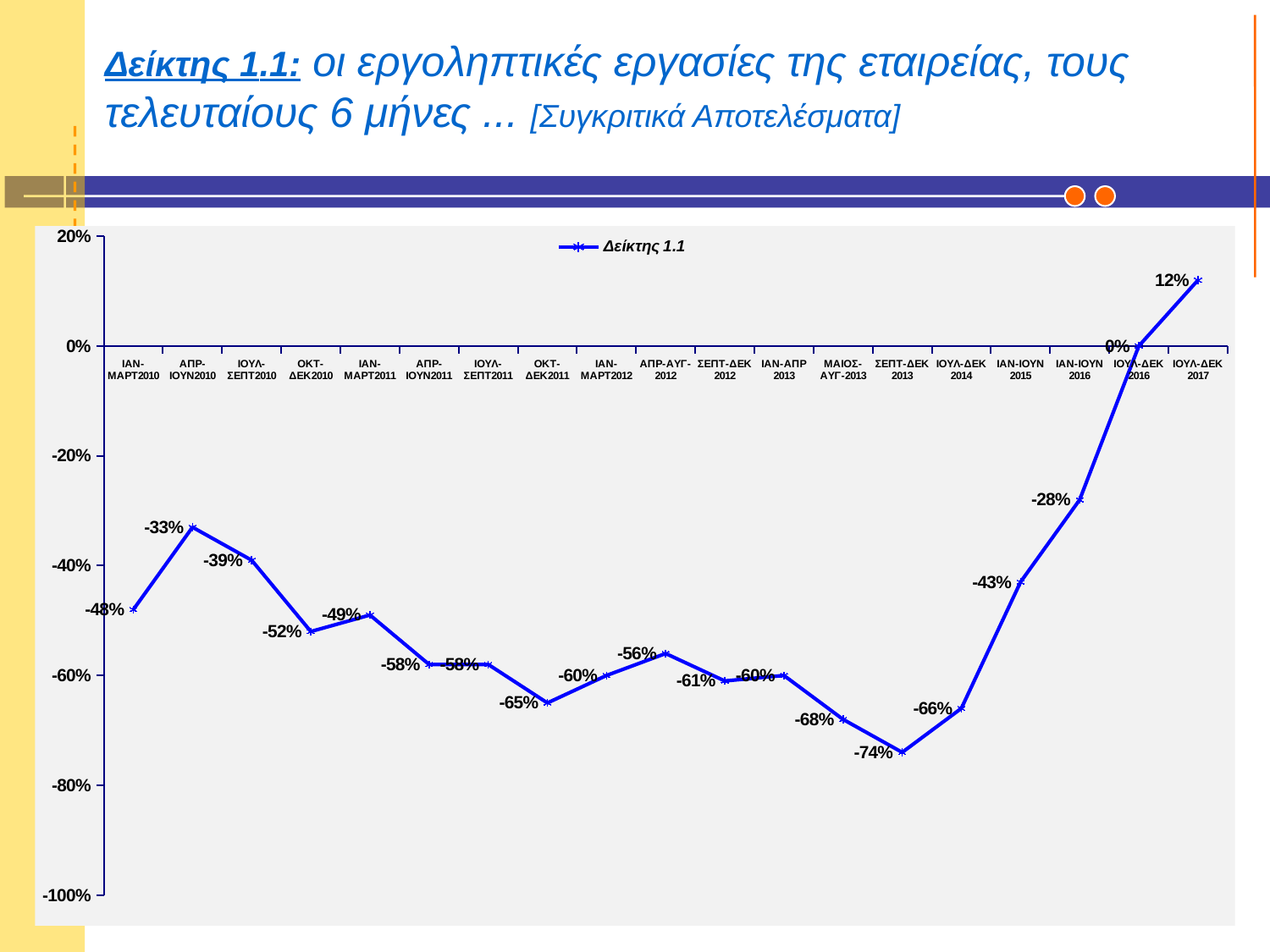
What type of chart is shown on the slide? line chart Which period has the lowest value of Δείκτης 1.1? ΣΕΠΤ-ΔΕΚ 2013 Which period has the highest value of Δείκτης 1.1? ΙΟΥΛ-ΔΕΚ 2017 How many data points are plotted on the line? 19 What is the value of Δείκτης 1.1 for ΙΑΝ-ΜΑΡΤ2010? -48% Does the value of Δείκτης 1.1 rise or fall from ΣΕΠΤ-ΔΕΚ 2013 to ΙΟΥΛ-ΔΕΚ 2017? rise Which is larger, the value for ΑΠΡ-ΙΟΥΝ2010 or the value for ΟΚΤ-ΔΕΚ2010? ΑΠΡ-ΙΟΥΝ2010 What is the difference between the values for ΙΟΥΛ-ΔΕΚ 2017 and ΣΕΠΤ-ΔΕΚ 2013? 86 percentage points What is the value of Δείκτης 1.1 for ΙΑΝ-ΙΟΥΝ 2016? -28% How many series does the legend list? 1 What is the value of Δείκτης 1.1 for ΣΕΠΤ-ΔΕΚ 2013? -74% What is the value of Δείκτης 1.1 for ΙΟΥΛ-ΔΕΚ 2017? 12%